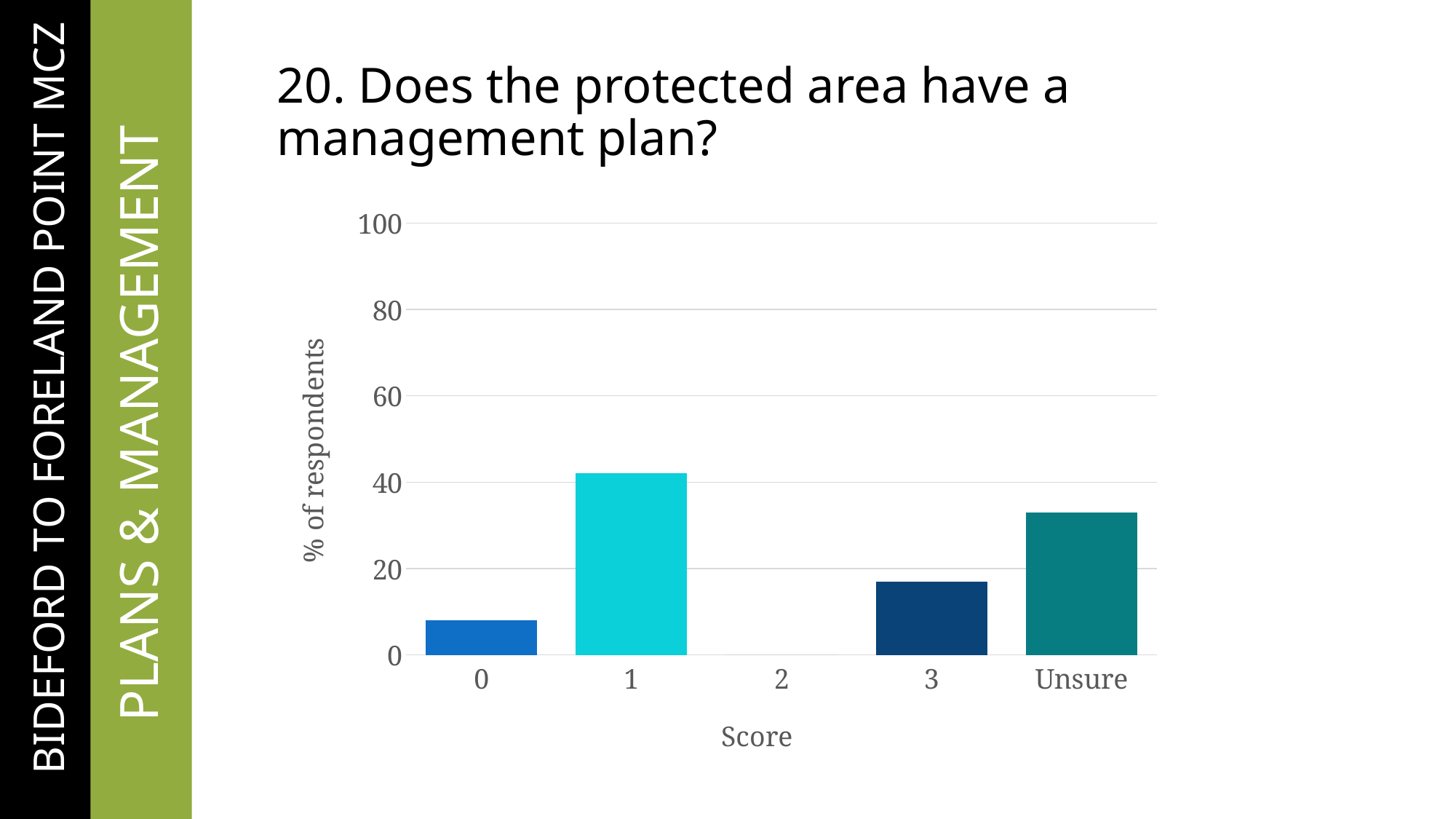
What is the value for score 2? 0 What kind of chart is shown on the slide? bar chart How many score categories are shown on the x axis? 5 Which score category has the lowest percentage of respondents? 2 Which is larger, the value for score 3 or the value for Unsure? Unsure What is the label on the x axis? Score Which score category has the highest percentage of respondents? 1 Is the value for Unsure greater or less than 40? less Is the value for score 0 greater or less than 20? less Is the value for score 3 greater or less than 20? less What is the label on the y axis? % of respondents